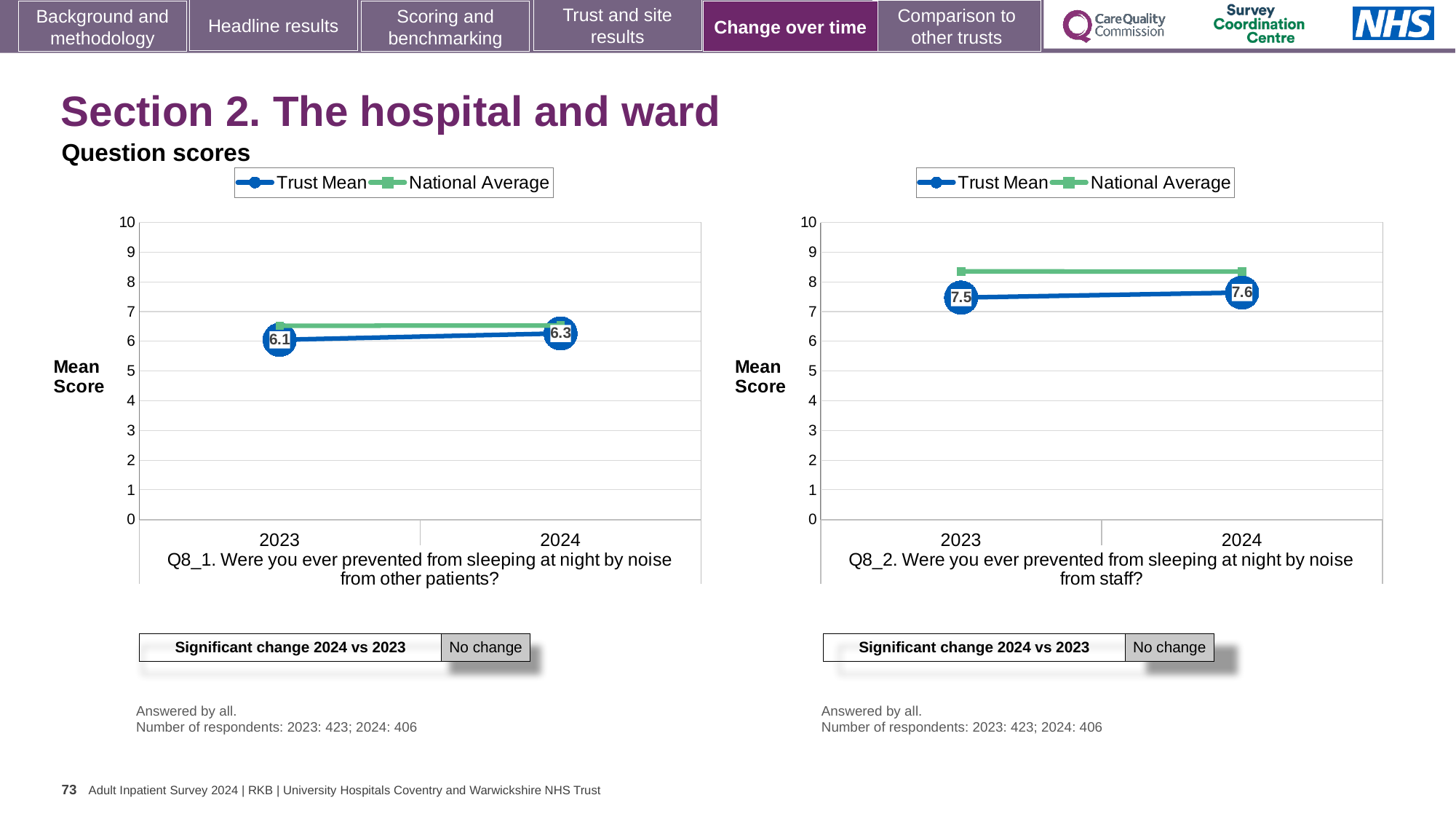
In the Q8_1 chart (left), by how much did the Trust Mean change from 2023 to 2024? 0.2 In the Q8_2 chart (right), what is the Trust Mean score for 2024? 7.6 In the Q8_2 chart (right), is the National Average for 2023 greater or less than 8? greater In the Q8_2 chart (right), does the Trust Mean rise or fall from 2023 to 2024? rise What type of chart is used for Q8_2 (right)? line chart In the Q8_2 chart (right), which is higher in 2023, the Trust Mean or the National Average? National Average In the Q8_1 chart (left), what is the Trust Mean score for 2024? 6.3 In the Q8_2 chart (right), what is the difference between the Trust Mean for 2024 and 2023? 0.1 In the Q8_1 chart (left), is the National Average for 2023 greater or less than 7? less In the Q8_2 chart (right), what is the Trust Mean score for 2023? 7.5 How many series does the legend of the Q8_1 chart (left) list? 2 In the Q8_1 chart (left), what is the Trust Mean score for 2023? 6.1